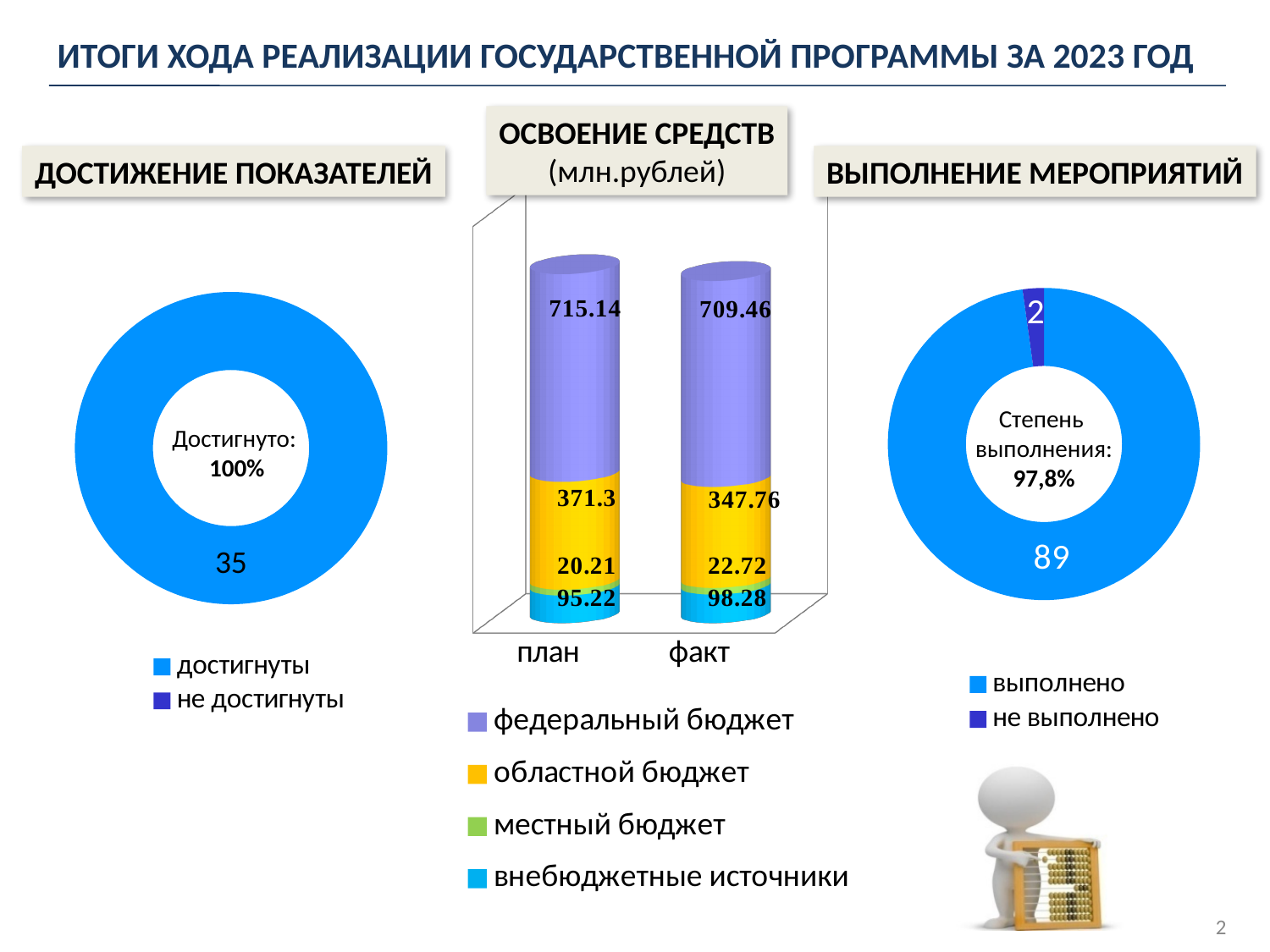
In the chart titled ОСВОЕНИЕ СРЕДСТВ, what is the value for областной бюджет in the факт bar? 347.76 In the chart titled ВЫПОЛНЕНИЕ МЕРОПРИЯТИЙ, what is the value for не выполнено? 2 In the chart titled ОСВОЕНИЕ СРЕДСТВ, is the местный бюджет value larger in план or in факт? факт In the chart titled ОСВОЕНИЕ СРЕДСТВ, which source has the largest value in the факт bar? федеральный бюджет In the chart titled ОСВОЕНИЕ СРЕДСТВ, what is the value for внебюджетные источники in the план bar? 95.22 In the chart titled ОСВОЕНИЕ СРЕДСТВ, which source has the smallest value in the план bar? местный бюджет In the chart titled ОСВОЕНИЕ СРЕДСТВ, what is the total of the план bar? 1201.87 In the chart titled ОСВОЕНИЕ СРЕДСТВ, what is the value for федеральный бюджет in the план bar? 715.14 In the chart titled ОСВОЕНИЕ СРЕДСТВ, what is the difference between the план and факт values for областной бюджет? 23.54 In the chart titled ОСВОЕНИЕ СРЕДСТВ, how many series does the legend list? 4 In the chart titled ДОСТИЖЕНИЕ ПОКАЗАТЕЛЕЙ, what is the value for достигнуты? 35 What kind of chart is the chart titled ОСВОЕНИЕ СРЕДСТВ? stacked bar chart